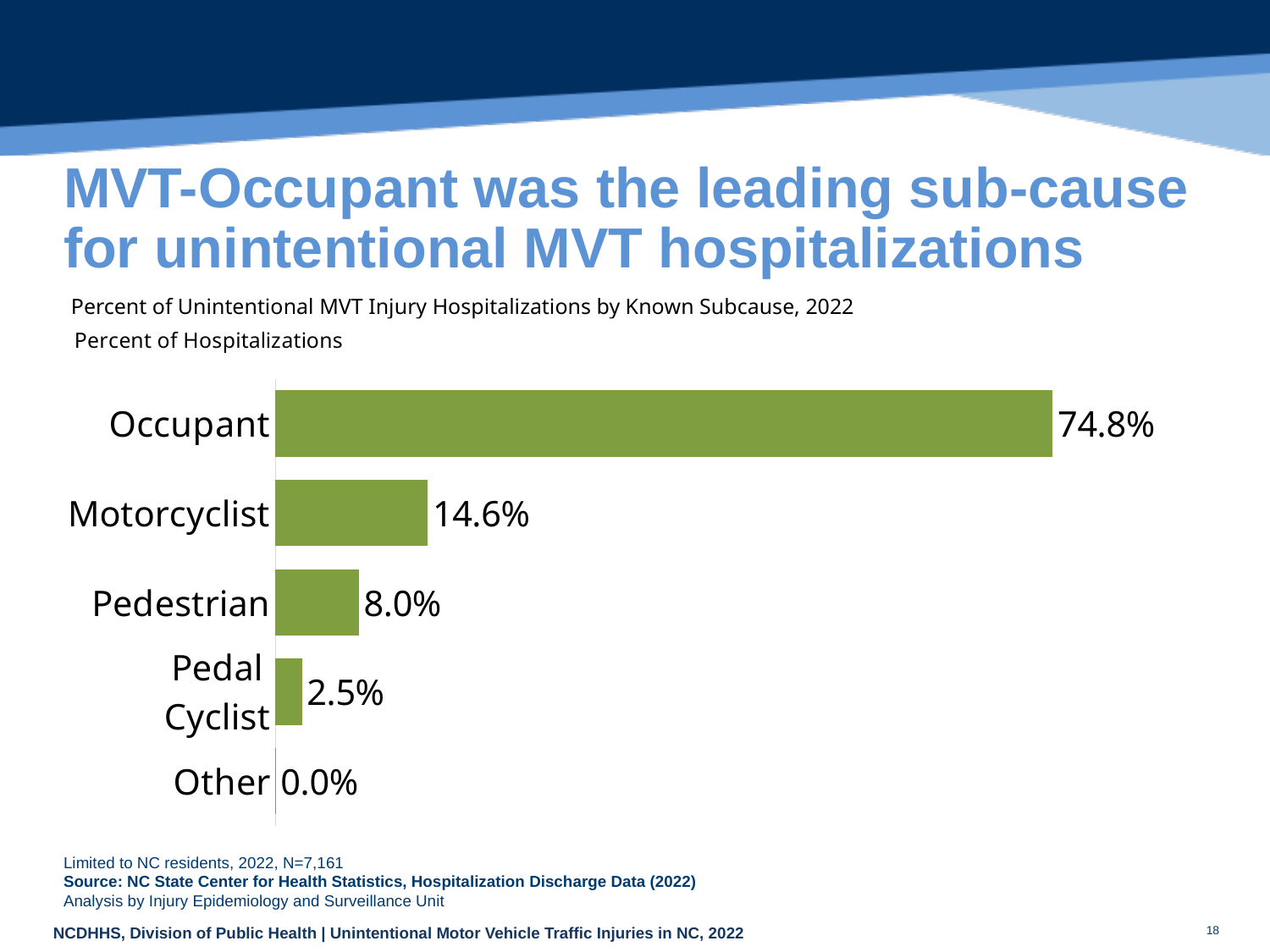
What is the difference in percentage points between Occupant and Motorcyclist? 60.2 Which subcause has the highest percent of hospitalizations? Occupant What is the value shown for Pedal Cyclist? 2.5% What is the value shown for Motorcyclist? 14.6% What kind of chart is shown on the slide? Bar chart What is the difference in percentage points between Motorcyclist and Pedestrian? 6.6 What is the title of the chart? Percent of Hospitalizations Which is larger, the value for Pedestrian or the value for Pedal Cyclist? Pedestrian What percent of hospitalizations is shown for Pedestrian? 8.0% How many subcause categories are shown in the chart? 5 What percent of unintentional MVT injury hospitalizations were for Occupant? 74.8% Which subcause has the lowest percent of hospitalizations? Other